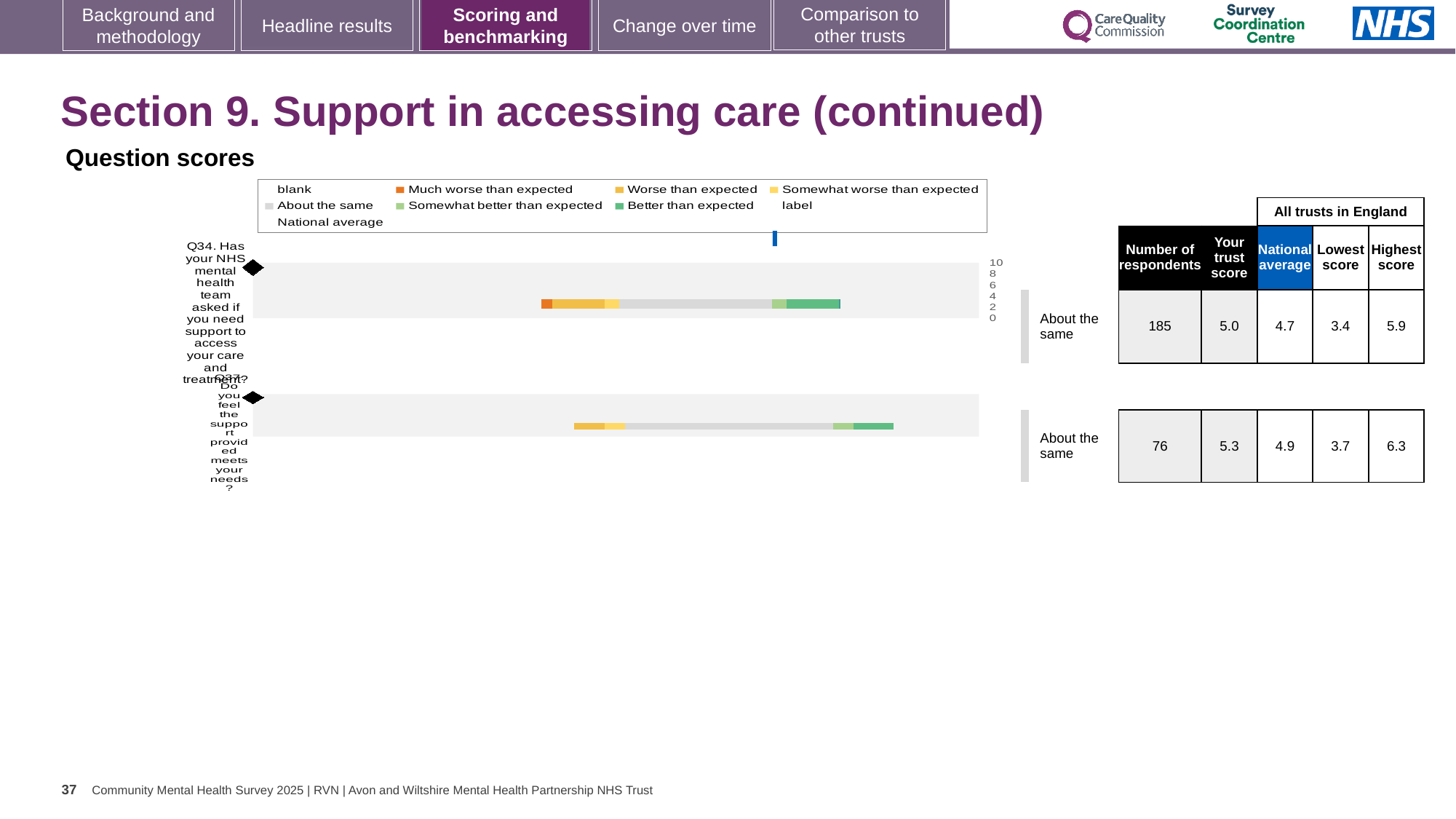
What is the highest value shown on the chart's axis? 10 What kind of chart is used to show the question scores on this slide? bar chart How many questions are plotted in the question scores chart? 2 What benchmarking category is shown for Q34? About the same Which question has the higher trust score, Q34 or Q37? Q37 What is the national average for Q34? 4.7 What is the trust score for Q37 (Do you feel the support provided meets your needs)? 5.3 What is the highest score among all trusts in England for Q37? 6.3 What is the number of respondents for Q37? 76 What is the difference between the trust score and the national average for Q37? 0.4 What is the lowest score among all trusts in England for Q34? 3.4 What is the trust score for Q34 (Has your NHS mental health team asked if you need support to access your care and treatment)? 5.0